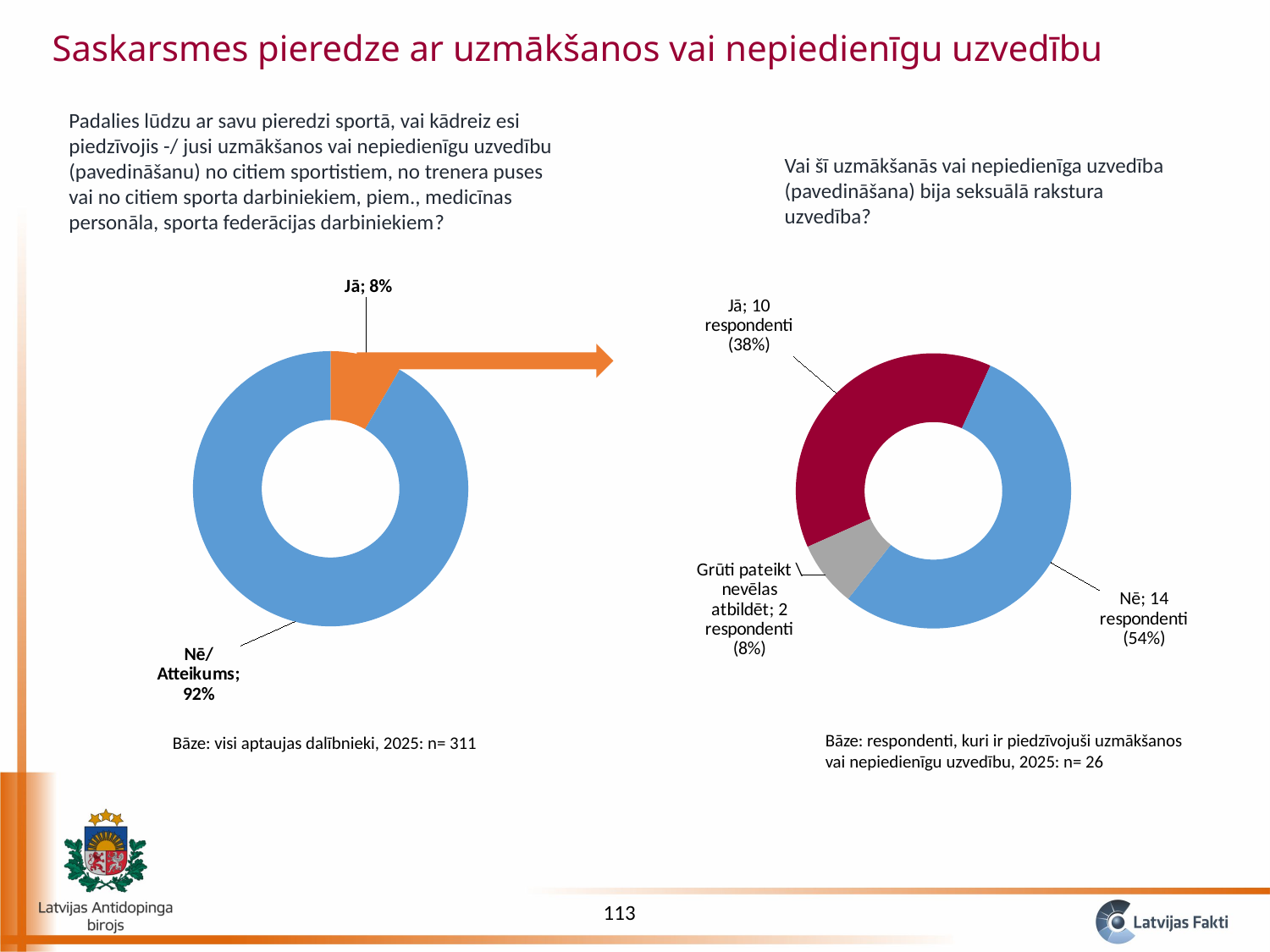
In the right chart, how many more respondents answered "Nē" than "Jā"? 4 In the right chart, how many respondents answered "Nē"? 14 respondenti In the right chart, what percentage of respondents answered "Jā"? 38% How many categories are shown in the right chart? 3 In the left chart, what percentage of respondents answered "Jā"? 8% In the right chart, how many respondents chose "Grūti pateikt / nevēlas atbildēt"? 2 respondenti What type of chart is the left chart? Doughnut chart In the right chart, which category has the largest share? Nē In the left chart, what is the difference in percentage points between "Nē/Atteikums" and "Jā"? 84 In the left chart, what percentage is shown for "Nē/Atteikums"? 92% What is the base (n) stated for the right chart? n= 26 In the right chart, which category has the smallest share? Grūti pateikt / nevēlas atbildēt